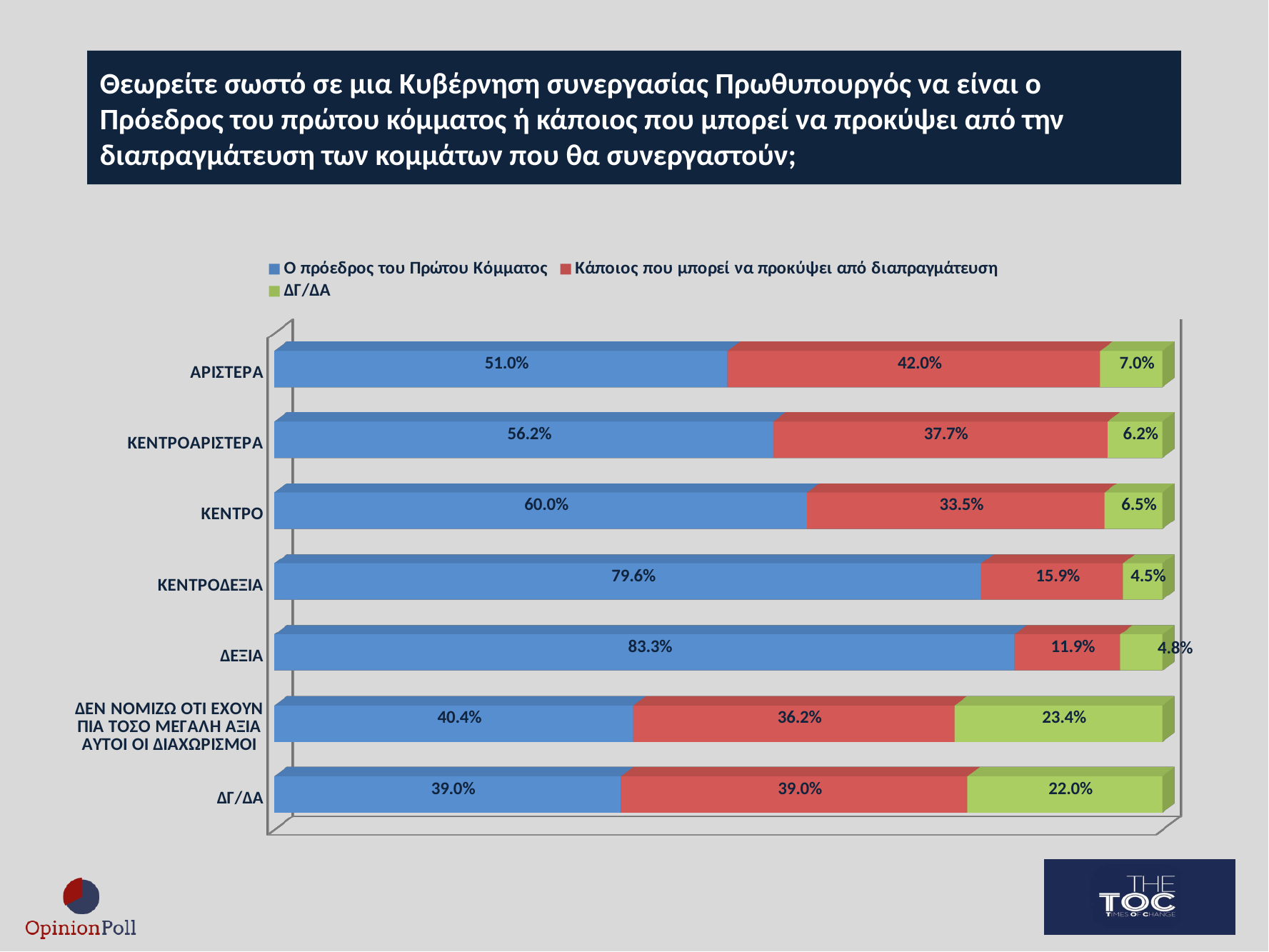
How many categories are shown on the vertical axis? 7 How many series does the legend list? 3 Which category has the highest ΔΓ/ΔΑ value? ΔΕΝ ΝΟΜΙΖΩ ΟΤΙ ΕΧΟΥΝ ΠΙΑ ΤΟΣΟ ΜΕΓΑΛΗ ΑΞΙΑ ΑΥΤΟΙ ΟΙ ΔΙΑΧΩΡΙΣΜΟΙ What is the value for 'Ο πρόεδρος του Πρώτου Κόμματος' in the ΔΕΞΙΑ category? 83.3% Which is larger for ΚΕΝΤΡΟΑΡΙΣΤΕΡΑ: 'Ο πρόεδρος του Πρώτου Κόμματος' or 'Κάποιος που μπορεί να προκύψει από διαπραγμάτευση'? Ο πρόεδρος του Πρώτου Κόμματος What is the value for 'Κάποιος που μπορεί να προκύψει από διαπραγμάτευση' in the ΑΡΙΣΤΕΡΑ category? 42.0% What type of chart is shown on the slide? Stacked bar chart Which category has the lowest value for 'Ο πρόεδρος του Πρώτου Κόμματος'? ΔΓ/ΔΑ Which category has the highest value for 'Ο πρόεδρος του Πρώτου Κόμματος'? ΔΕΞΙΑ What is the difference between the 'Ο πρόεδρος του Πρώτου Κόμματος' values for ΚΕΝΤΡΟΔΕΞΙΑ and ΚΕΝΤΡΟ? 19.6% Which colour represents the ΔΓ/ΔΑ series in the chart? Green What is the ΔΓ/ΔΑ value for the ΚΕΝΤΡΟ category? 6.5%